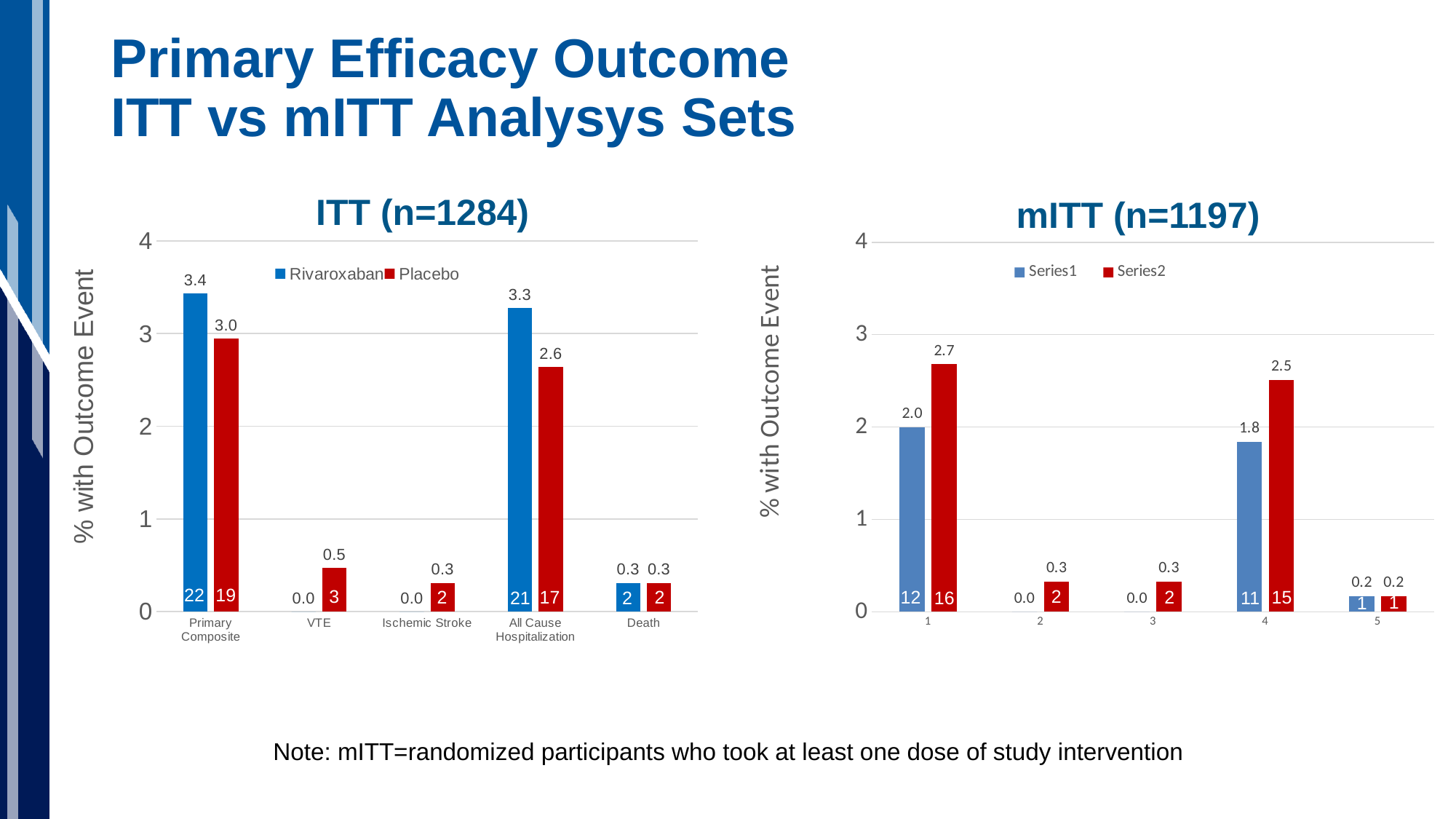
In the ITT (n=1284) chart, what is the value for Rivaroxaban in the Primary Composite category? 3.4 In the mITT (n=1197) chart, what is the value for Series2 in category 1? 2.7 In the ITT (n=1284) chart, which category has the highest Rivaroxaban value? Primary Composite In the ITT (n=1284) chart, what is the difference between the Rivaroxaban and Placebo values for Primary Composite? 0.4 How many series does the legend of the ITT (n=1284) chart list? 2 In the ITT (n=1284) chart, which is larger for All Cause Hospitalization, Rivaroxaban or Placebo? Rivaroxaban In the mITT (n=1197) chart, which category has the lowest Series2 value? 5 In the ITT (n=1284) chart, what is the value for Placebo in the VTE category? 0.5 In the mITT (n=1197) chart, what is the difference between Series2 and Series1 in category 4? 0.7 What kind of chart is the mITT (n=1197) chart? Bar chart In the ITT (n=1284) chart, what is the value for Placebo in the All Cause Hospitalization category? 2.6 How many categories are shown on the x axis of the ITT (n=1284) chart? 5